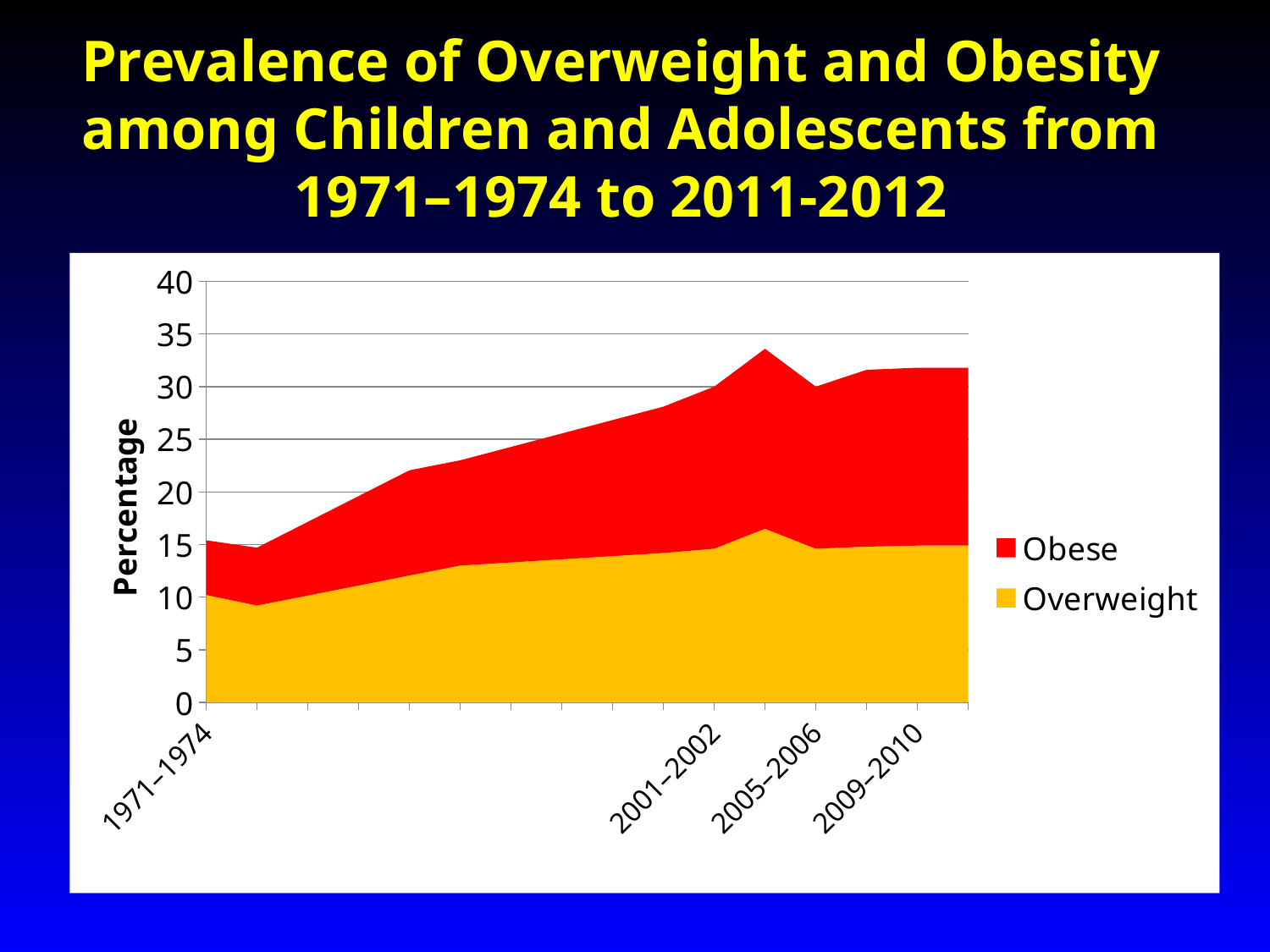
Which two series are listed in the chart legend? Obese and Overweight Is the combined (Overweight plus Obese) value for 2009–2010 greater or less than 35? less What is the label on the vertical axis of the chart? Percentage Does the combined prevalence of overweight and obesity generally rise or fall from 1971–1974 to 2011-2012? rise Among the labeled periods, which has the highest combined (Overweight plus Obese) prevalence? 2009–2010 What kind of chart is shown on the slide? Stacked area chart Is the combined (Overweight plus Obese) value for 1971–1974 greater or less than 20? less Is the Overweight value for 2001–2002 greater or less than 20? less How many series does the legend list? 2 Which is larger, the combined prevalence in 2005–2006 or in 1971–1974? 2005–2006